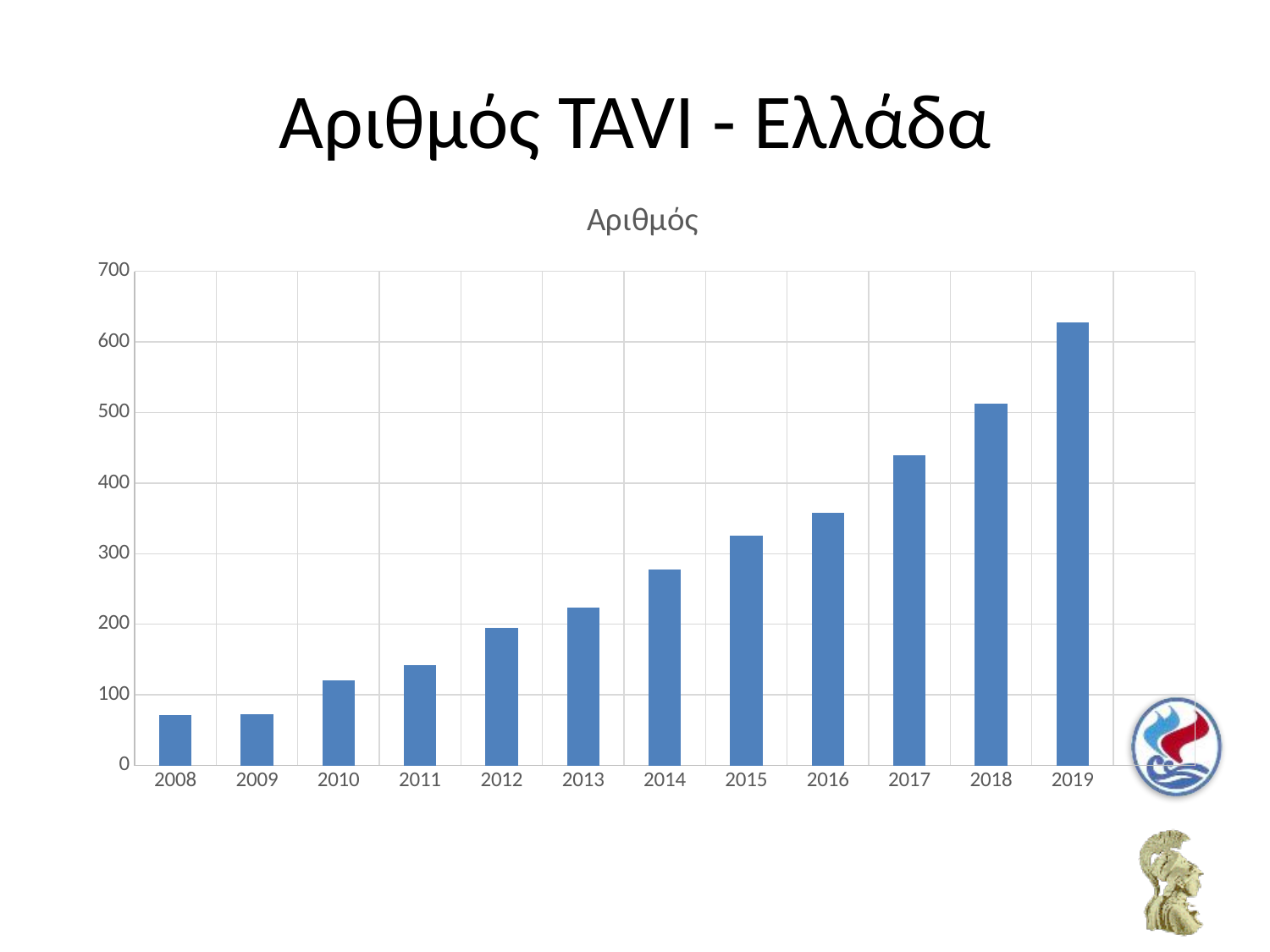
Which year has the highest value in the chart? 2019 Is the value for 2014 greater or less than 300? less Is the value for 2017 greater or less than 400? greater What is the title printed above the chart area? Αριθμός Do the values generally rise or fall from 2008 to 2019? rise What is the title of the slide? Αριθμός TAVI - Ελλάδα Is the value for 2015 greater or less than 300? greater What kind of chart is shown on the slide? bar chart How many years are shown on the x axis of the chart? 12 Which is larger, the value for 2018 or the value for 2017? 2018